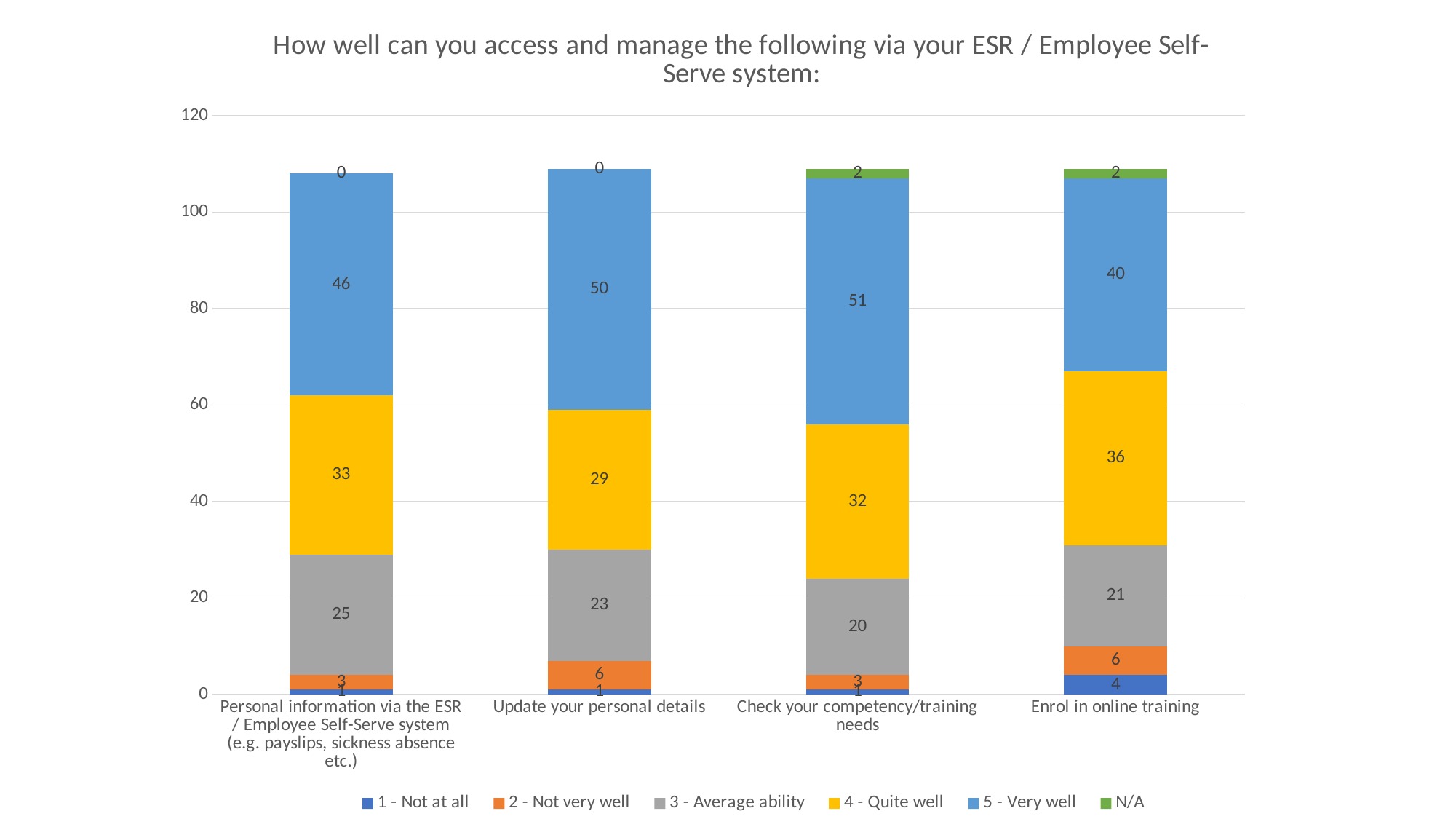
What is the value for '4 - Quite well' for 'Enrol in online training'? 36 How many categories are shown on the x axis? 4 What is the value for '3 - Average ability' for 'Check your competency/training needs'? 20 How many series does the legend list? 6 What is the value for '1 - Not at all' for 'Enrol in online training'? 4 Which is larger: the '3 - Average ability' value for 'Personal information via the ESR / Employee Self-Serve system' or for 'Update your personal details'? Personal information via the ESR / Employee Self-Serve system Which category has the highest value for '5 - Very well'? Check your competency/training needs What type of chart is shown on the slide? stacked bar chart What is the total of the stacked bar for 'Enrol in online training'? 109 What is the value for '5 - Very well' for 'Update your personal details'? 50 What is the difference between the '4 - Quite well' values for 'Enrol in online training' and 'Update your personal details'? 7 Which category has the lowest value for '5 - Very well'? Enrol in online training